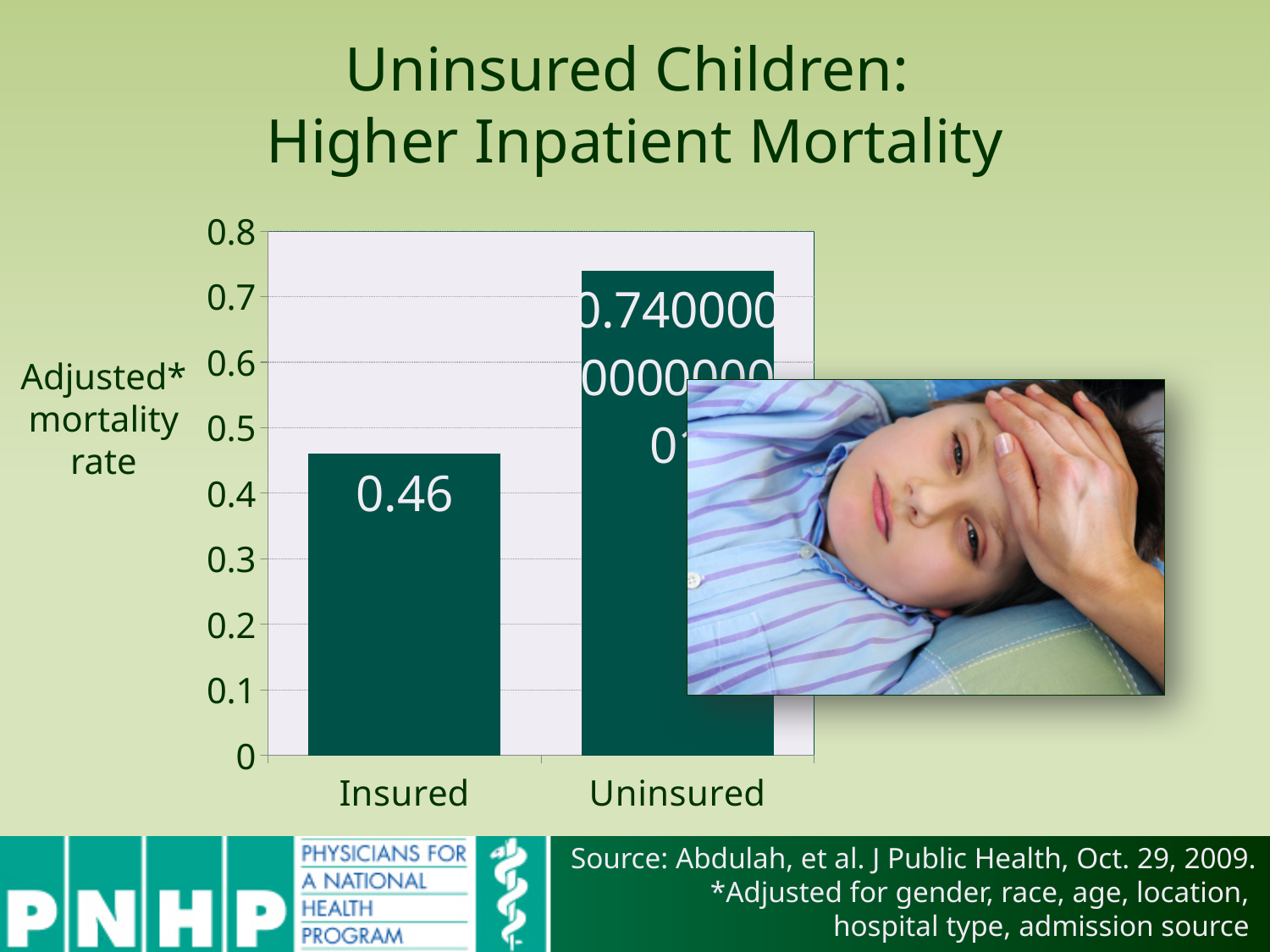
What is the adjusted mortality rate for Insured children? 0.46 What is the highest value shown on the vertical axis of the chart? 0.8 Which category has the lower adjusted mortality rate? Insured Is the adjusted mortality rate for Insured children greater or less than 0.5? less Which is larger, the adjusted mortality rate for Insured or for Uninsured children? Uninsured What is the title of the slide containing the chart? Uninsured Children: Higher Inpatient Mortality Is the adjusted mortality rate for Uninsured children greater or less than 0.7? greater What kind of chart is shown on the slide? bar chart Which category has the higher adjusted mortality rate? Uninsured Is the adjusted mortality rate for Uninsured children greater or less than 0.6? greater How many categories are shown on the x axis of the chart? 2 What is the label on the vertical axis of the chart? Adjusted* mortality rate